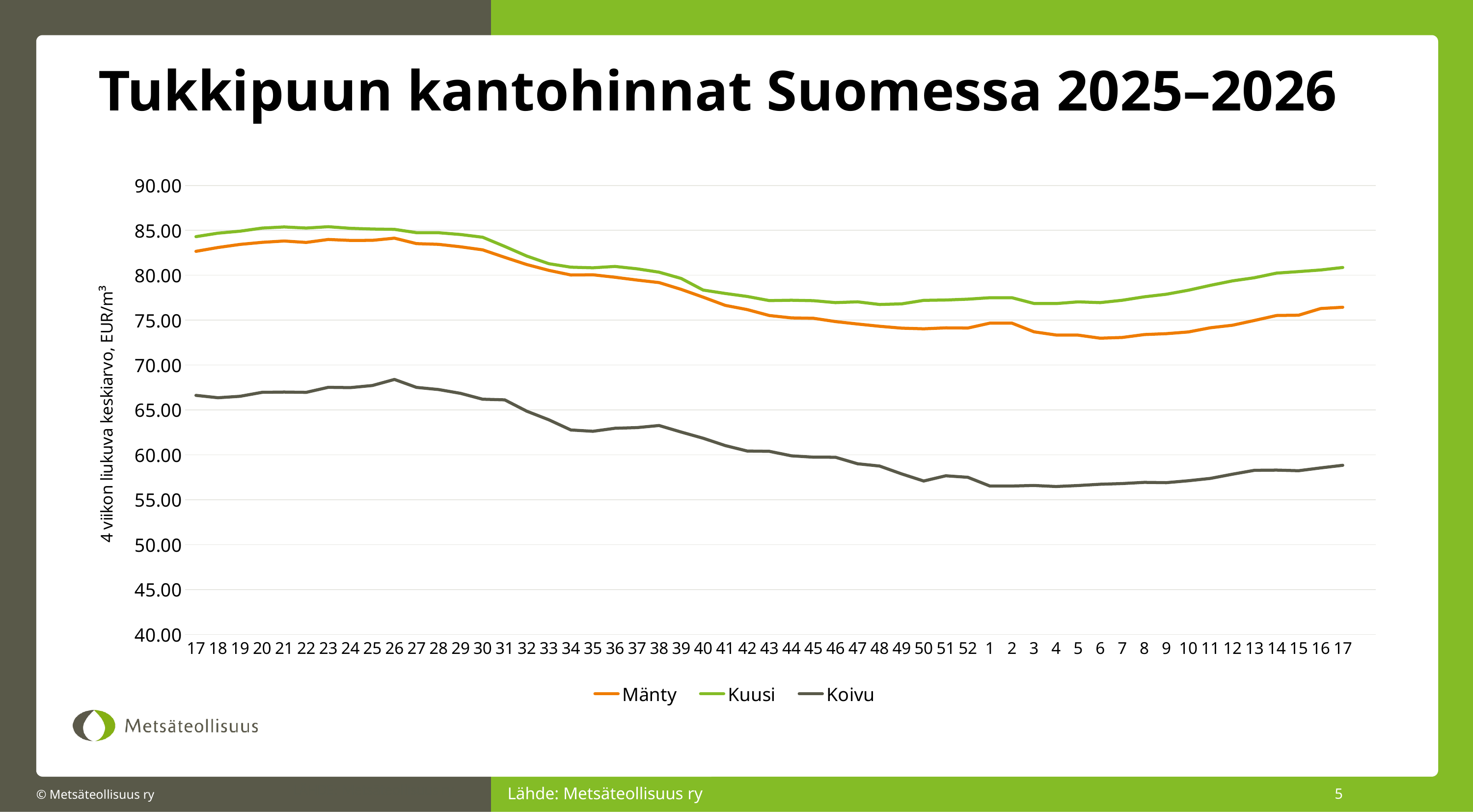
Which series has the lowest values throughout the chart? Koivu Is the value for Kuusi at week 48 greater or less than 80.00? less Does the Koivu line rise or fall between week 26 and week 1? fall What kind of chart is shown on the slide? line chart Is the value for Koivu at week 26 greater or less than 65.00? greater Is the value for Mänty at week 6 greater or less than 75.00? less At week 40, which is higher, Kuusi or Mänty? Kuusi How many series does the legend list? 3 What is the title of the chart? Tukkipuun kantohinnat Suomessa 2025–2026 Which series has the highest values throughout the chart? Kuusi Does the Mänty line rise or fall between week 6 and the final week 17? rise